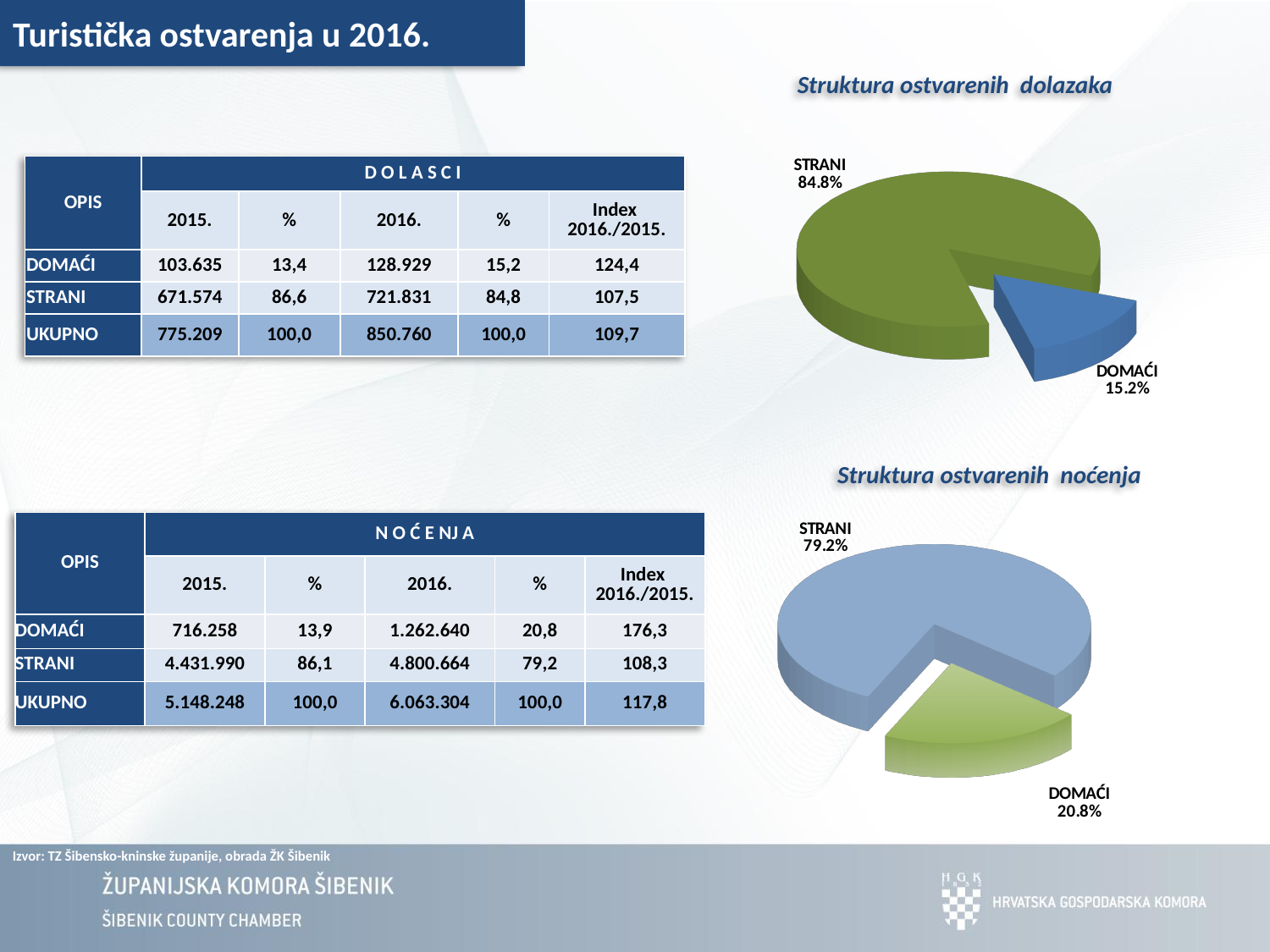
What type of chart is 'Struktura ostvarenih dolazaka'? Pie chart In the 'Struktura ostvarenih dolazaka' chart, what is the difference in percentage points between STRANI and DOMAĆI? 69.6 In the 'Struktura ostvarenih dolazaka' chart, which category has the largest slice? STRANI In the 'Struktura ostvarenih noćenja' chart, which category has the smallest slice? DOMAĆI In the 'Struktura ostvarenih noćenja' chart, what is the difference in percentage points between STRANI and DOMAĆI? 58.4 How many slices does the 'Struktura ostvarenih noćenja' chart have? 2 In the 'Struktura ostvarenih dolazaka' chart, what share does DOMAĆI have? 15.2% In the 'Struktura ostvarenih dolazaka' chart, what share does STRANI have? 84.8% Is the DOMAĆI share larger in the 'Struktura ostvarenih dolazaka' chart or in the 'Struktura ostvarenih noćenja' chart? Struktura ostvarenih noćenja In the 'Struktura ostvarenih noćenja' chart, what share does STRANI have? 79.2% In the 'Struktura ostvarenih noćenja' chart, what share does DOMAĆI have? 20.8% In the 'Struktura ostvarenih dolazaka' chart, what colour is the STRANI slice? Green